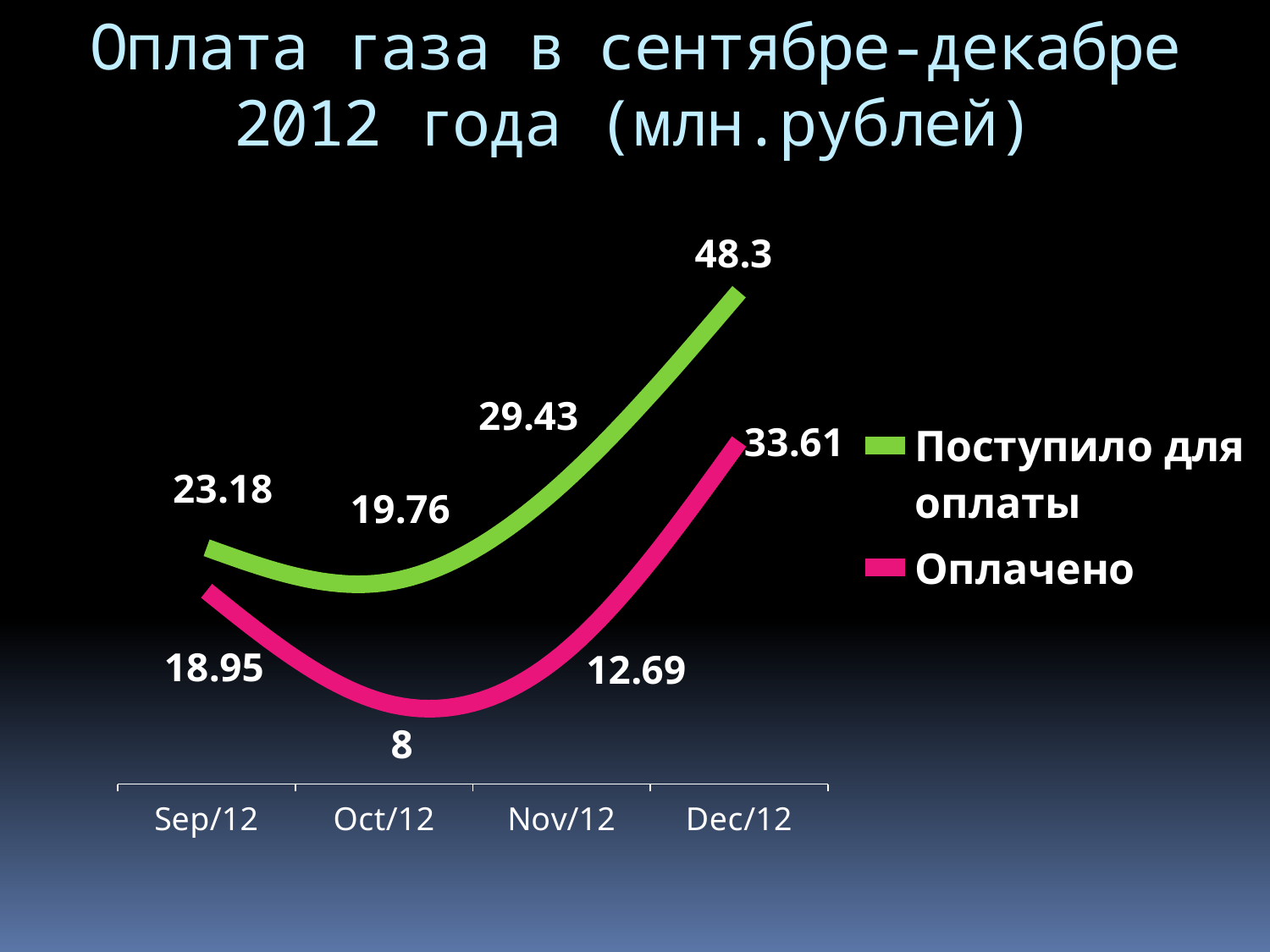
Which is larger in Nov/12: Поступило для оплаты or Оплачено? Поступило для оплаты What is the difference between Поступило для оплаты and Оплачено in Dec/12? 14.69 What is the value of Поступило для оплаты for Sep/12? 23.18 How many series does the legend list? 2 What is the value of Оплачено for Nov/12? 12.69 In which month is Оплачено the lowest? Oct/12 In which month is Поступило для оплаты the highest? Dec/12 What is the value of Поступило для оплаты for Dec/12? 48.3 What colour is the line for Оплачено? Pink What kind of chart is shown on the slide? Line chart How many months are shown on the x axis? 4 What is the value of Оплачено for Oct/12? 8